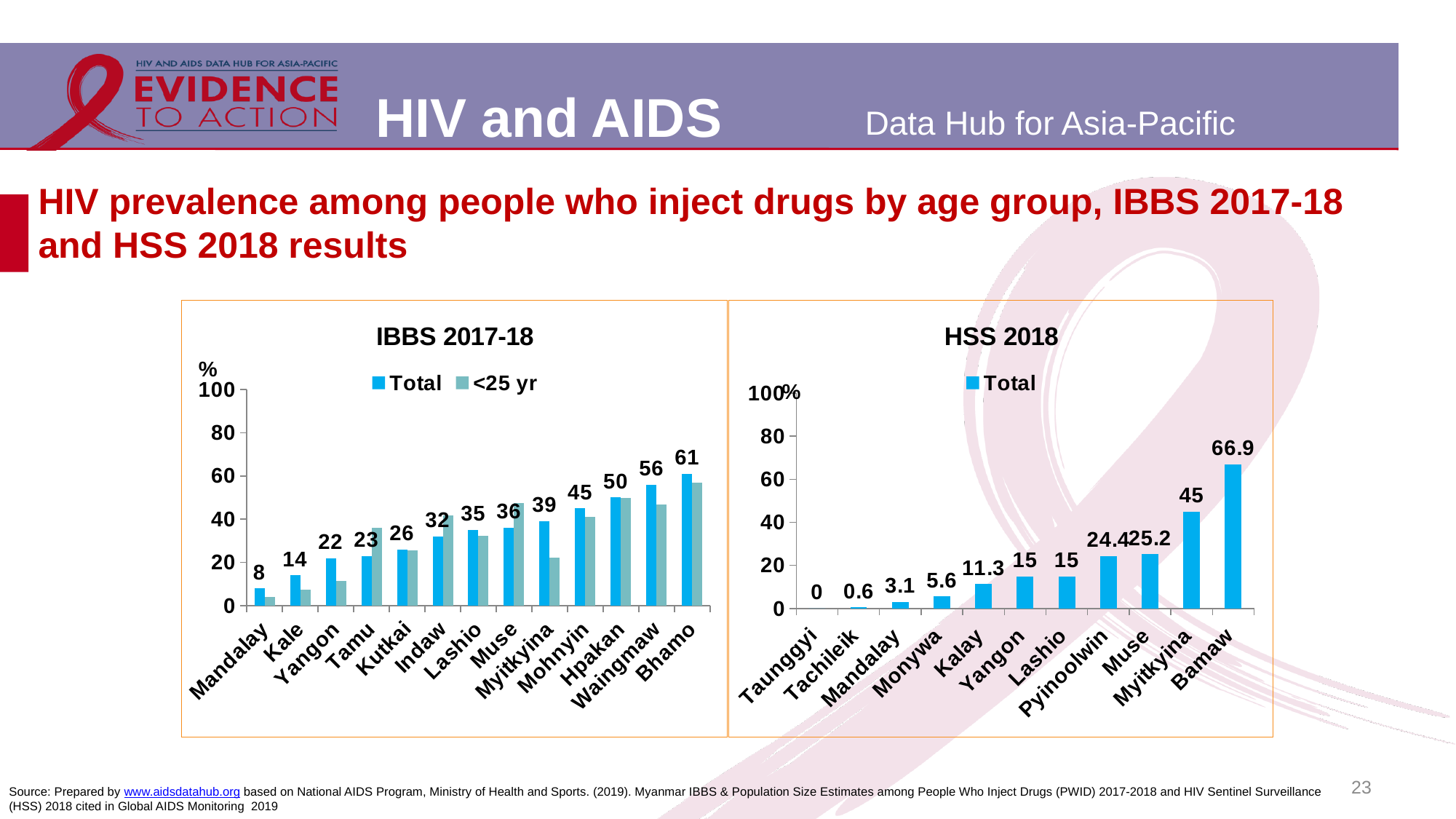
What kind of chart is the HSS 2018 chart? Bar chart In the HSS 2018 chart, what is the difference between the Total values for Bamaw and Myitkyina? 21.9 How many series does the legend of the IBBS 2017-18 chart list? 2 In the IBBS 2017-18 chart, which has the larger Total value, Hpakan or Mohnyin? Hpakan In the HSS 2018 chart, which site has the highest Total value? Bamaw In the IBBS 2017-18 chart, is the <25 yr value for Mandalay greater or less than 20? less In the HSS 2018 chart, what is the Total value for Pyinoolwin? 24.4 In the IBBS 2017-18 chart, which site has the lowest Total value? Mandalay In the HSS 2018 chart, do the Total values rise or fall from Taunggyi to Bamaw? Rise How many sites are shown on the x axis of the HSS 2018 chart? 11 In the IBBS 2017-18 chart, what is the difference between the Total values for Bhamo and Mandalay? 53 In the IBBS 2017-18 chart, what is the Total HIV prevalence for Lashio? 35